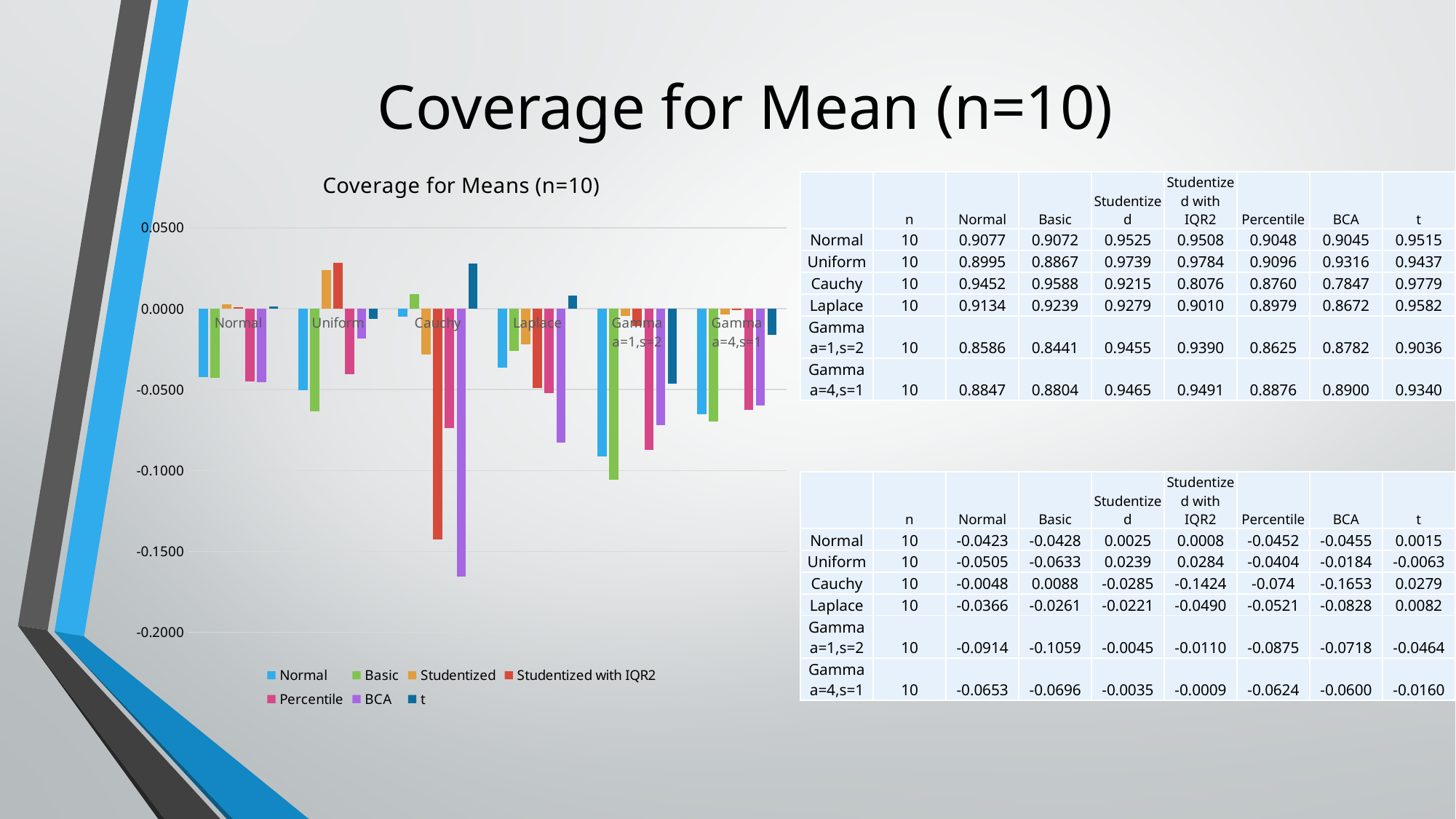
Is the value for Basic in the Gamma a=1,s=2 category greater or less than -0.1000? less How many series does the chart legend list? 7 What kind of chart is shown on the slide? bar chart How many distribution categories are shown on the x axis of the chart? 6 For the Normal series, which category has the larger value: Gamma a=1,s=2 or Gamma a=4,s=1? Gamma a=4,s=1 Which category and series has the lowest bar in the chart? Cauchy, BCA Is the value for Studentized with IQR2 in the Cauchy category greater or less than -0.1000? less Is the value for Normal in the Normal category greater or less than -0.0500? greater What is the difference between the Normal and Basic values in the Uniform category? 0.0128 What is the plotted value for Studentized in the Normal category? 0.0025 What is the plotted value for BCA in the Cauchy category? -0.1653 What is the title of the chart? Coverage for Means (n=10)